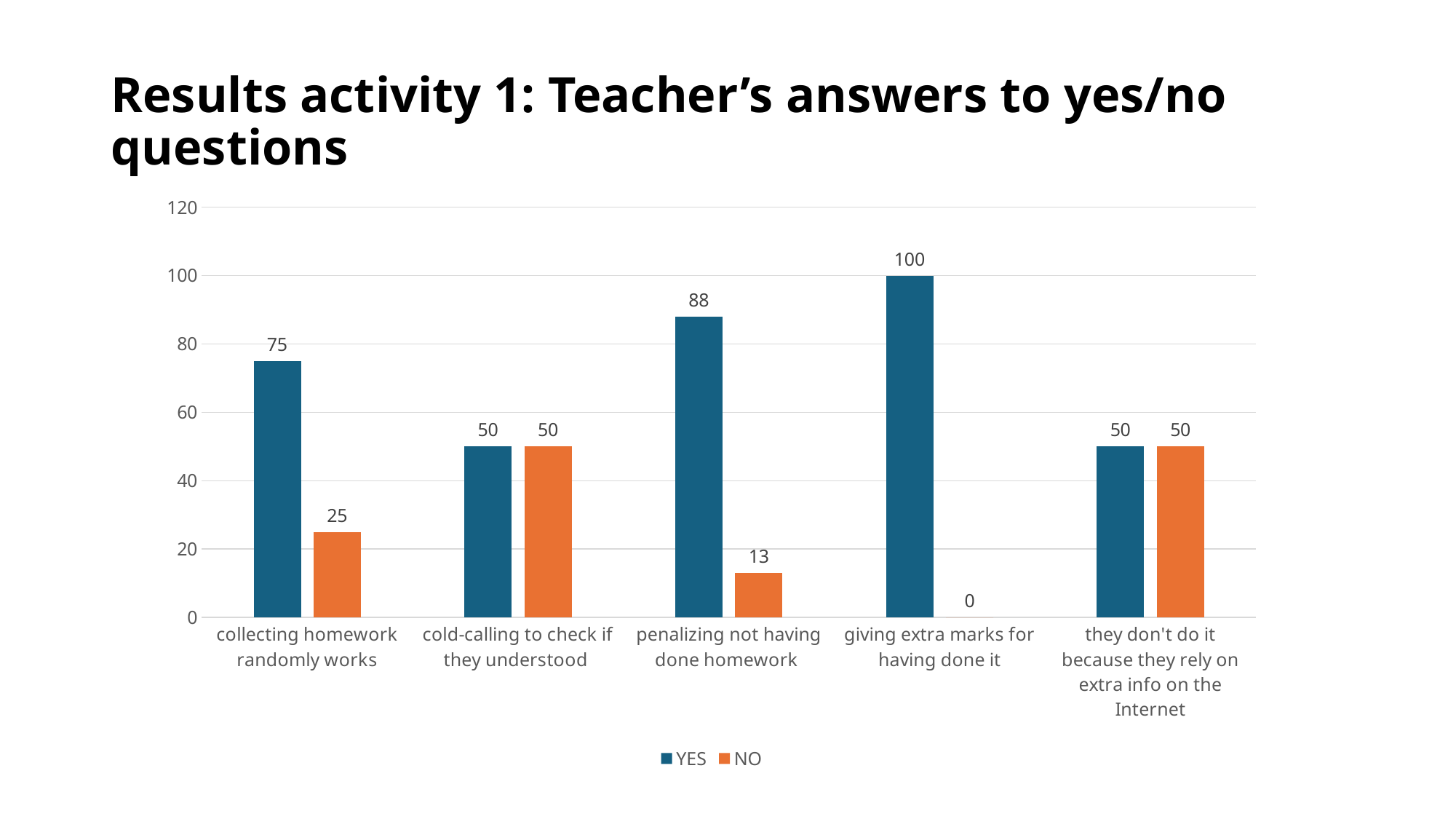
Which is larger for "penalizing not having done homework": the YES value or the NO value? YES Which category has the highest YES value? giving extra marks for having done it Which category has the lowest NO value? giving extra marks for having done it What is the title of the slide? Results activity 1: Teacher's answers to yes/no questions How many categories are shown on the x axis? 5 What is the NO value for "giving extra marks for having done it"? 0 What colour are the NO bars? orange What is the difference between the YES and NO values for "collecting homework randomly works"? 50 How many series does the legend list? 2 What is the YES value for "collecting homework randomly works"? 75 What is the NO value for "penalizing not having done homework"? 13 What kind of chart is shown on the slide? bar chart